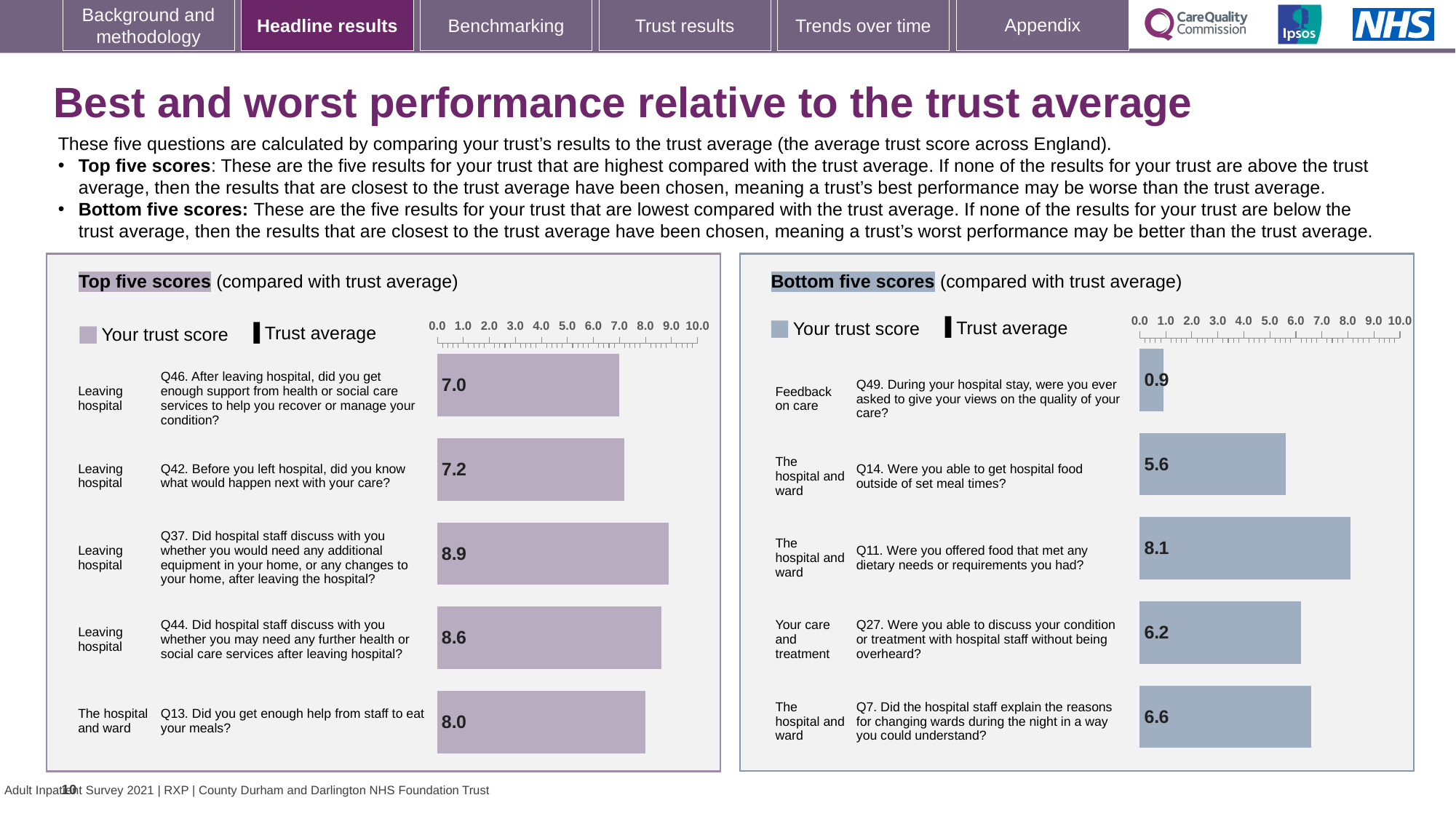
In the Top five scores chart, what is the difference between the trust scores for Q37 and Q44? 0.3 In the Bottom five scores chart, what is the difference between the trust scores for Q11 and Q49? 7.2 What type of chart is the Top five scores chart? Bar chart In the Bottom five scores chart, which question has the highest trust score? Q11 In the Top five scores chart, what is the trust score for Q42 (Before you left hospital, did you know what would happen next with your care?)? 7.2 In the Bottom five scores chart, what is the trust score for Q49 (During your hospital stay, were you ever asked to give your views on the quality of your care?)? 0.9 In the Top five scores chart, which question has the highest trust score? Q37 In the Bottom five scores chart, which is larger, the trust score for Q14 or for Q7? Q7 How many questions are shown in the Bottom five scores chart? 5 In the Top five scores chart, which question has the lowest trust score? Q46 In the Bottom five scores chart, what is the trust score for Q27 (Were you able to discuss your condition or treatment with hospital staff without being overheard?)? 6.2 In the Top five scores chart, what is the trust score for Q13 (Did you get enough help from staff to eat your meals?)? 8.0